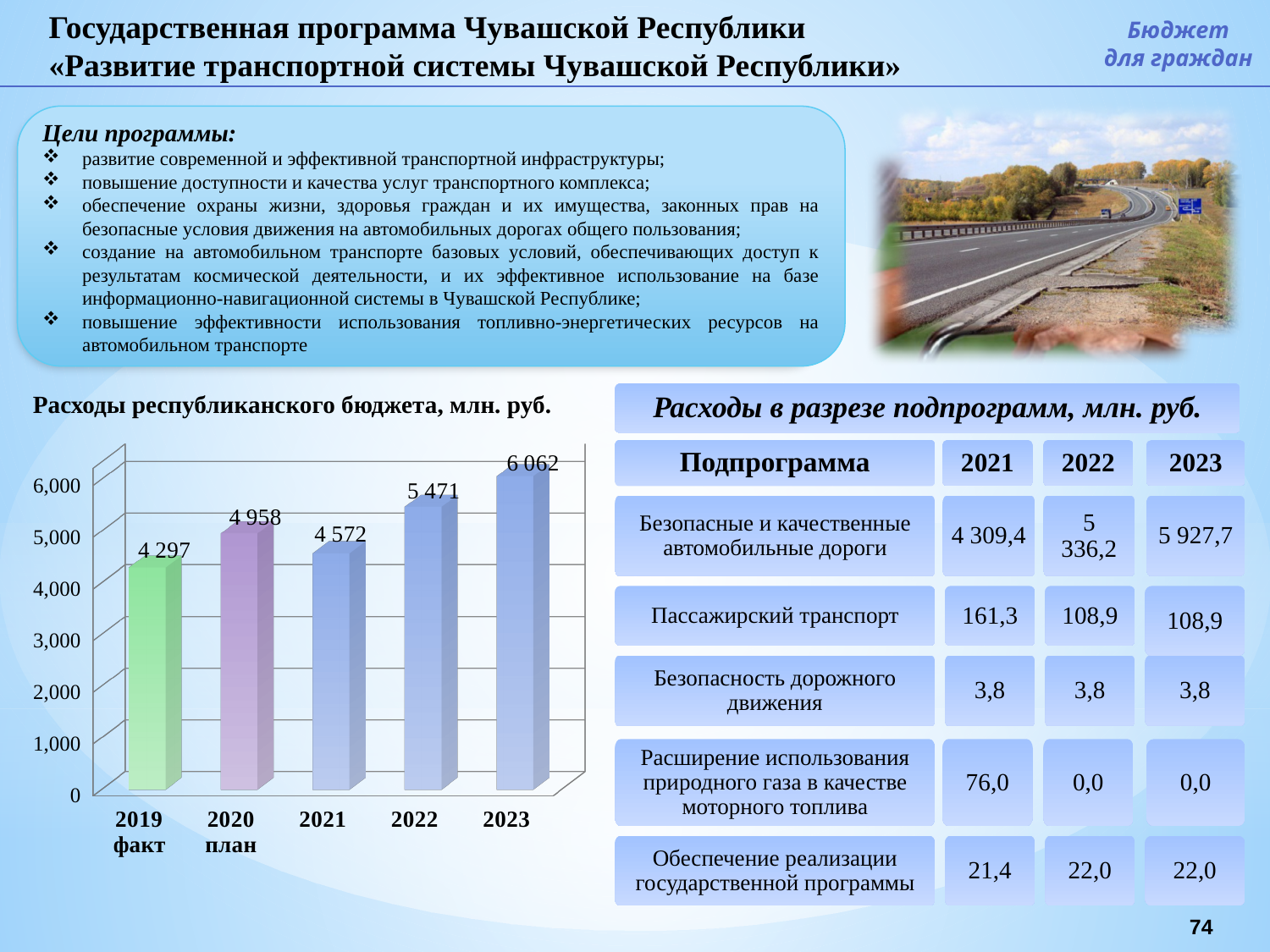
What is the value for 2021 in the chart 'Расходы республиканского бюджета, млн. руб.'? 4 572 What is the difference between the values for 2020 план and 2021 in the chart? 386 What is the difference between the values for 2023 and 2022 in the chart? 591 Which category has the lowest value in the chart? 2019 факт What is the value for 2019 факт in the chart? 4 297 What kind of chart is shown on the slide? bar chart Is the value for 2022 in the chart greater or less than 5,000? greater What is the value for 2023 in the chart? 6 062 How many bars are shown in the chart? 5 Which is larger in the chart: the value for 2020 план or the value for 2021? 2020 план Do the values in the chart rise or fall from 2021 to 2023? rise Which year has the highest value in the chart? 2023